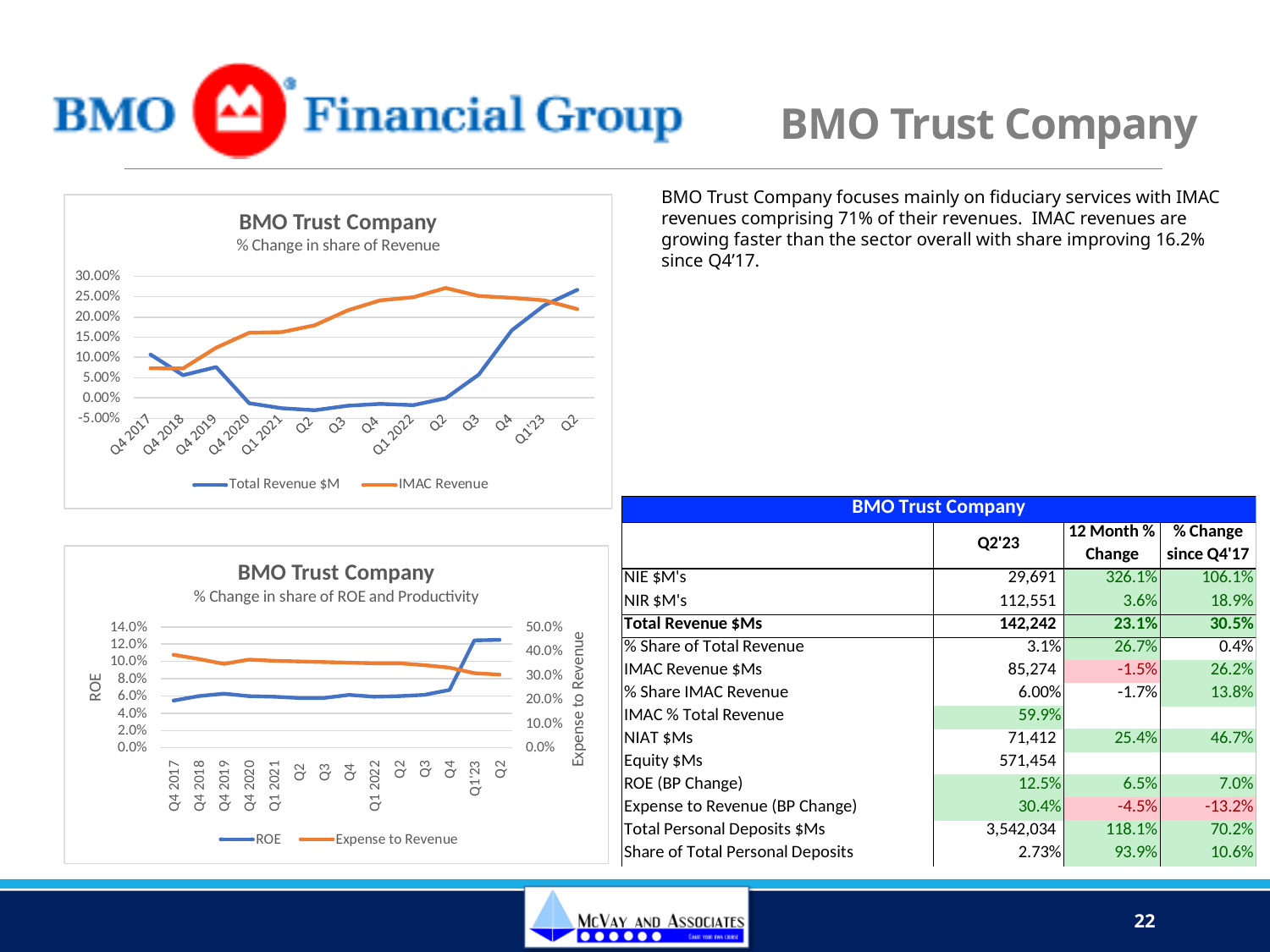
In the top chart (% Change in share of Revenue), is the Total Revenue $M value at Q3 2021 greater or less than 0.00%? less In the top chart (% Change in share of Revenue), at which quarter does the IMAC Revenue line reach its highest point? Q2 2022 How many series does the legend of the top chart (% Change in share of Revenue) list? 2 In the bottom chart (% Change in share of ROE and Productivity), does the Expense to Revenue line generally rise or fall from Q4 2017 to Q2 2023? fall What is the subtitle of the bottom chart on the slide? % Change in share of ROE and Productivity In the top chart (% Change in share of Revenue), which series is higher at Q2 2022: Total Revenue $M or IMAC Revenue? IMAC Revenue What type of chart is the top chart titled 'BMO Trust Company – % Change in share of Revenue'? Line chart What are the two series named in the legend of the top chart (% Change in share of Revenue)? Total Revenue $M and IMAC Revenue In the bottom chart (% Change in share of ROE and Productivity), is the Expense to Revenue value at the final Q2 point greater or less than 40.0%? less In the top chart (% Change in share of Revenue), how many quarters are plotted along the x axis? 14 In the bottom chart (% Change in share of ROE and Productivity), is the ROE value at Q1'23 greater or less than 10.0%? greater